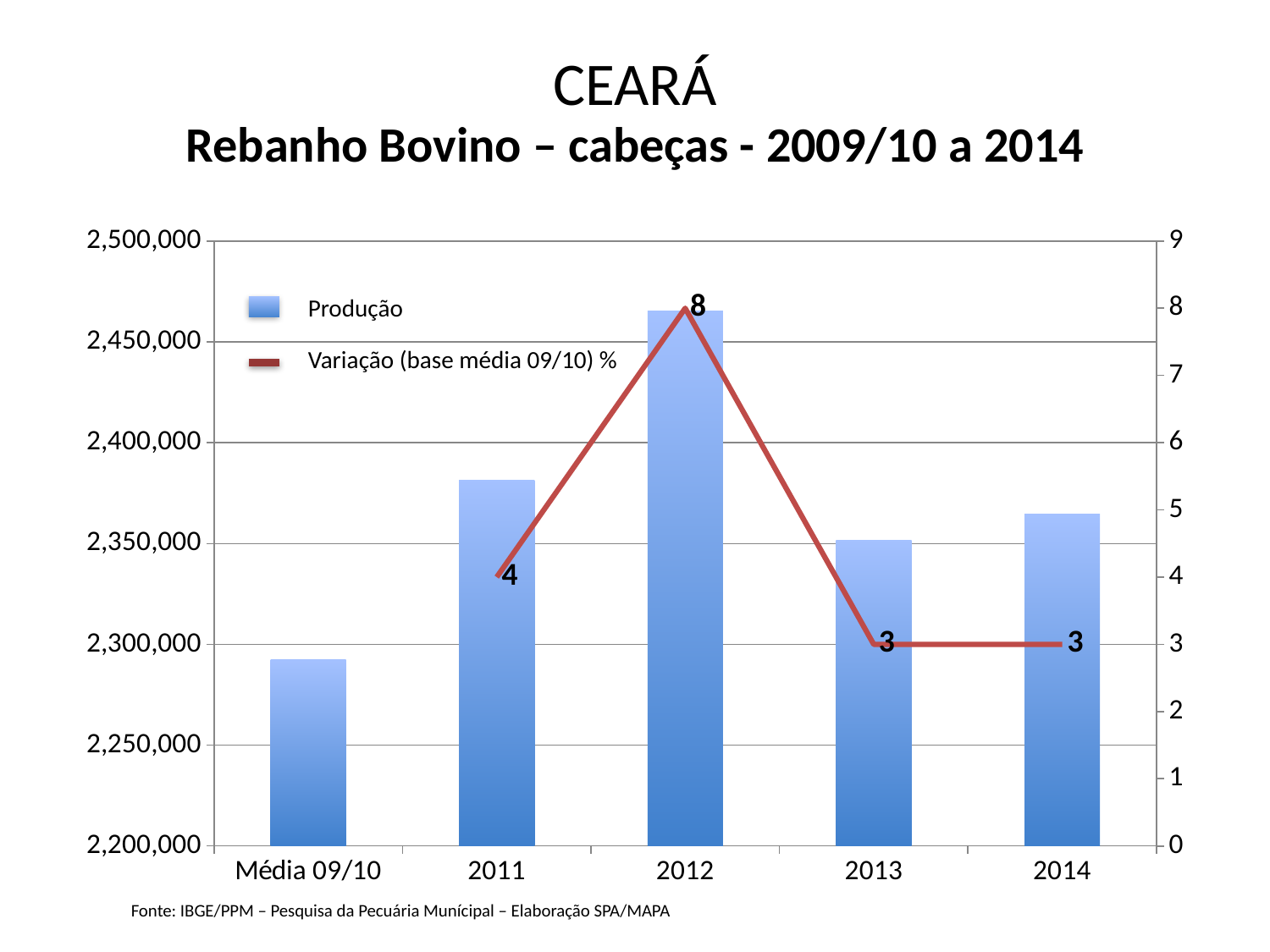
How many series does the legend list? 2 How many categories are shown on the x axis? 5 Is the Produção value for 2012 greater or less than 2,450,000? greater What is the difference between the Variação values for 2012 and 2011? 4 What is the Variação (base média 09/10) % value for 2011? 4 Which category has the lowest Produção bar? Média 09/10 Which category has the highest Produção bar? 2012 Is the Produção value for Média 09/10 greater or less than 2,300,000? less Which has the larger Produção value, 2011 or 2013? 2011 What kind of chart is shown on the slide? Combined bar and line chart What is the Variação (base média 09/10) % value for 2014? 3 What is the Variação (base média 09/10) % value for 2012? 8